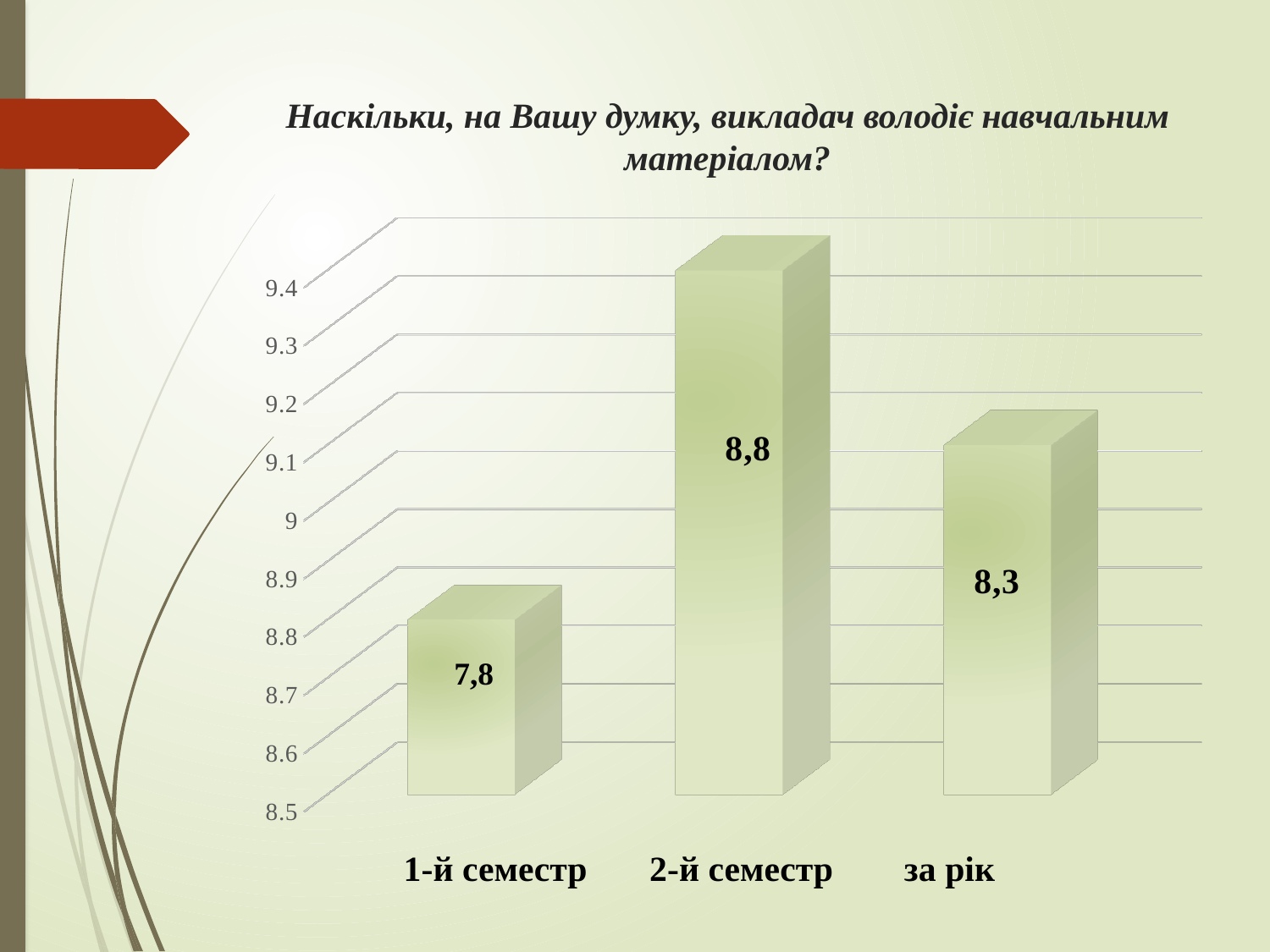
Which category has the lowest value? 1-й семестр What is the value for 1-й семестр? 7,8 What is the value for за рік? 8,3 What is the difference between the values for 2-й семестр and 1-й семестр? 1,0 What is the value for 2-й семестр? 8,8 What is the lowest value shown on the vertical axis? 8.5 How many categories are shown on the chart? 3 Which is larger, the value for за рік or the value for 1-й семестр? за рік Which category has the highest value? 2-й семестр What is the difference between the values for 2-й семестр and за рік? 0,5 What is the title of the chart? Наскільки, на Вашу думку, викладач володіє навчальним матеріалом? What kind of chart is shown on the slide? bar chart